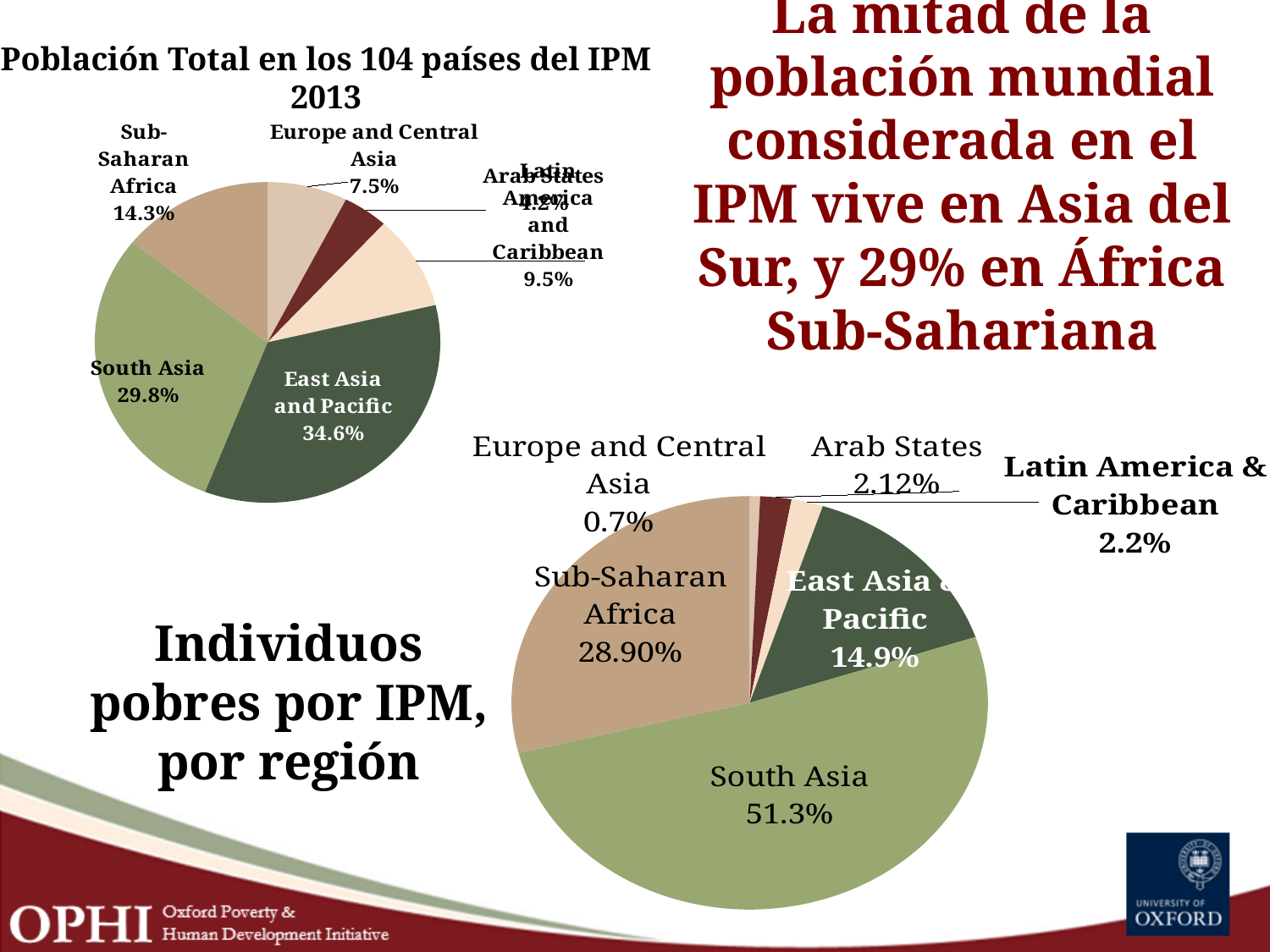
In the pie chart titled 'Población Total en los 104 países del IPM 2013', what share does East Asia and Pacific have? 34.6% In the pie chart 'Individuos pobres por IPM, por región', what share does Europe and Central Asia have? 0.7% In the pie chart titled 'Población Total en los 104 países del IPM 2013', what is the difference between the shares of East Asia and Pacific and South Asia? 4.8 percentage points What type of chart is used for 'Individuos pobres por IPM, por región'? Pie chart In the pie chart 'Individuos pobres por IPM, por región', how many regions are shown? 6 In the pie chart 'Individuos pobres por IPM, por región', what share does South Asia have? 51.3% In the pie chart 'Individuos pobres por IPM, por región', which region has the smallest share? Europe and Central Asia In the pie chart titled 'Población Total en los 104 países del IPM 2013', what share does Sub-Saharan Africa have? 14.3% In the pie chart titled 'Población Total en los 104 países del IPM 2013', which region has the largest share? East Asia and Pacific In the pie chart titled 'Población Total en los 104 países del IPM 2013', what share does South Asia have? 29.8% In the pie chart 'Individuos pobres por IPM, por región', what share does Sub-Saharan Africa have? 28.90% In the pie chart 'Individuos pobres por IPM, por región', which is larger, the share of East Asia and Pacific or the share of Sub-Saharan Africa? Sub-Saharan Africa